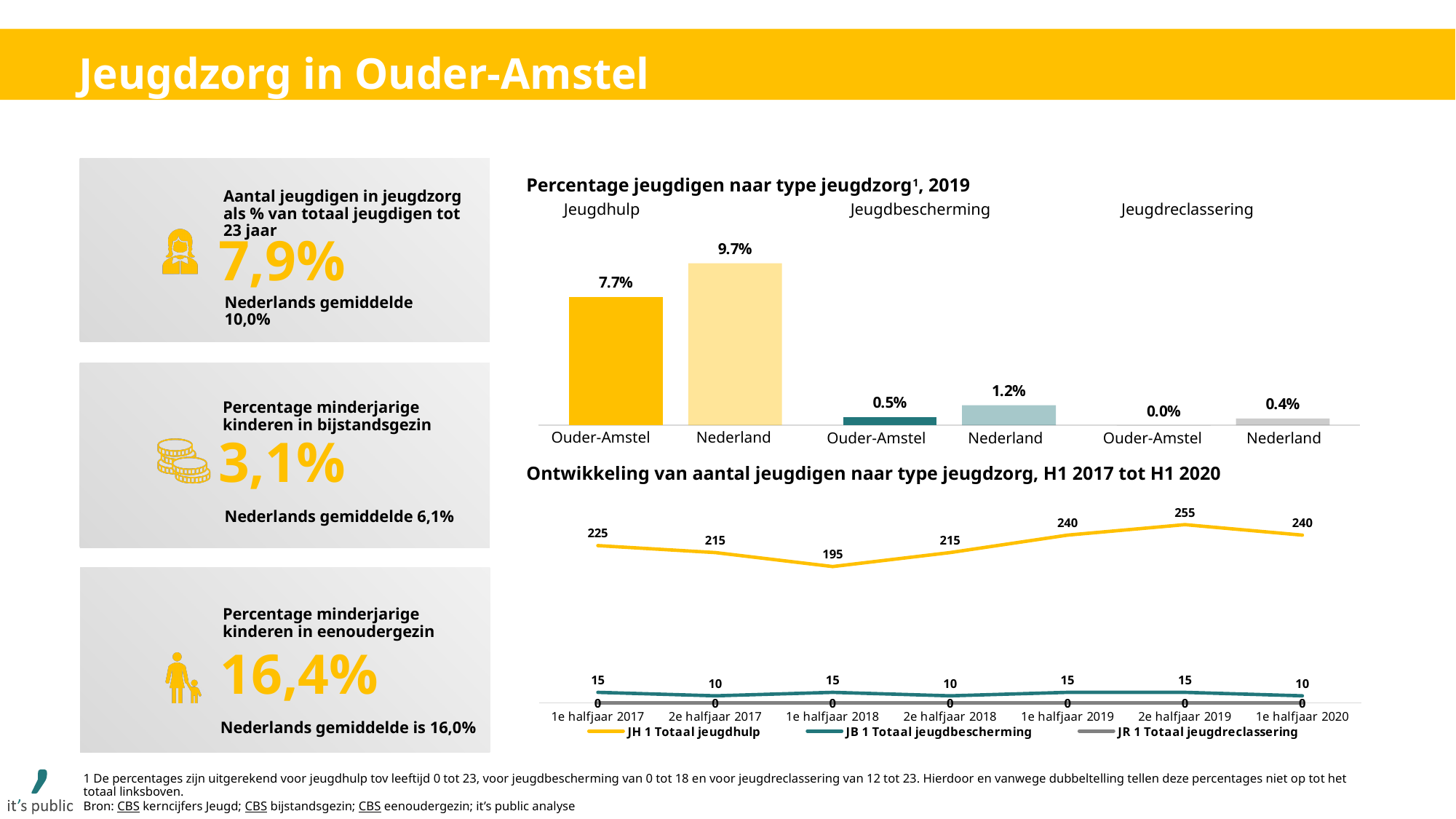
In the chart 'Ontwikkeling van aantal jeugdigen naar type jeugdzorg, H1 2017 tot H1 2020', what is the value of JH 1 Totaal jeugdhulp in 2e halfjaar 2019? 255 In the chart 'Ontwikkeling van aantal jeugdigen naar type jeugdzorg, H1 2017 tot H1 2020', how many series does the legend list? 3 In the chart 'Percentage jeugdigen naar type jeugdzorg, 2019', what is the Jeugdbescherming value for Nederland? 1.2% In the chart 'Percentage jeugdigen naar type jeugdzorg, 2019', what is the Jeugdhulp value for Ouder-Amstel? 7.7% In the chart 'Ontwikkeling van aantal jeugdigen naar type jeugdzorg, H1 2017 tot H1 2020', what is the difference between JH 1 Totaal jeugdhulp in 1e halfjaar 2017 and 1e halfjaar 2018? 30 In the chart 'Percentage jeugdigen naar type jeugdzorg, 2019', which bar has the highest value? Nederland (Jeugdhulp) In the chart 'Ontwikkeling van aantal jeugdigen naar type jeugdzorg, H1 2017 tot H1 2020', how many time periods are shown on the x axis? 7 In the chart 'Percentage jeugdigen naar type jeugdzorg, 2019', is the Jeugdreclassering value higher for Ouder-Amstel or for Nederland? Nederland In the chart 'Ontwikkeling van aantal jeugdigen naar type jeugdzorg, H1 2017 tot H1 2020', what is the value of JR 1 Totaal jeugdreclassering in 1e halfjaar 2020? 0 What kind of chart is 'Percentage jeugdigen naar type jeugdzorg, 2019'? Bar chart In the chart 'Percentage jeugdigen naar type jeugdzorg, 2019', what is the difference between the Jeugdhulp values for Nederland and Ouder-Amstel? 2.0% In the chart 'Ontwikkeling van aantal jeugdigen naar type jeugdzorg, H1 2017 tot H1 2020', in which period is JH 1 Totaal jeugdhulp lowest? 1e halfjaar 2018